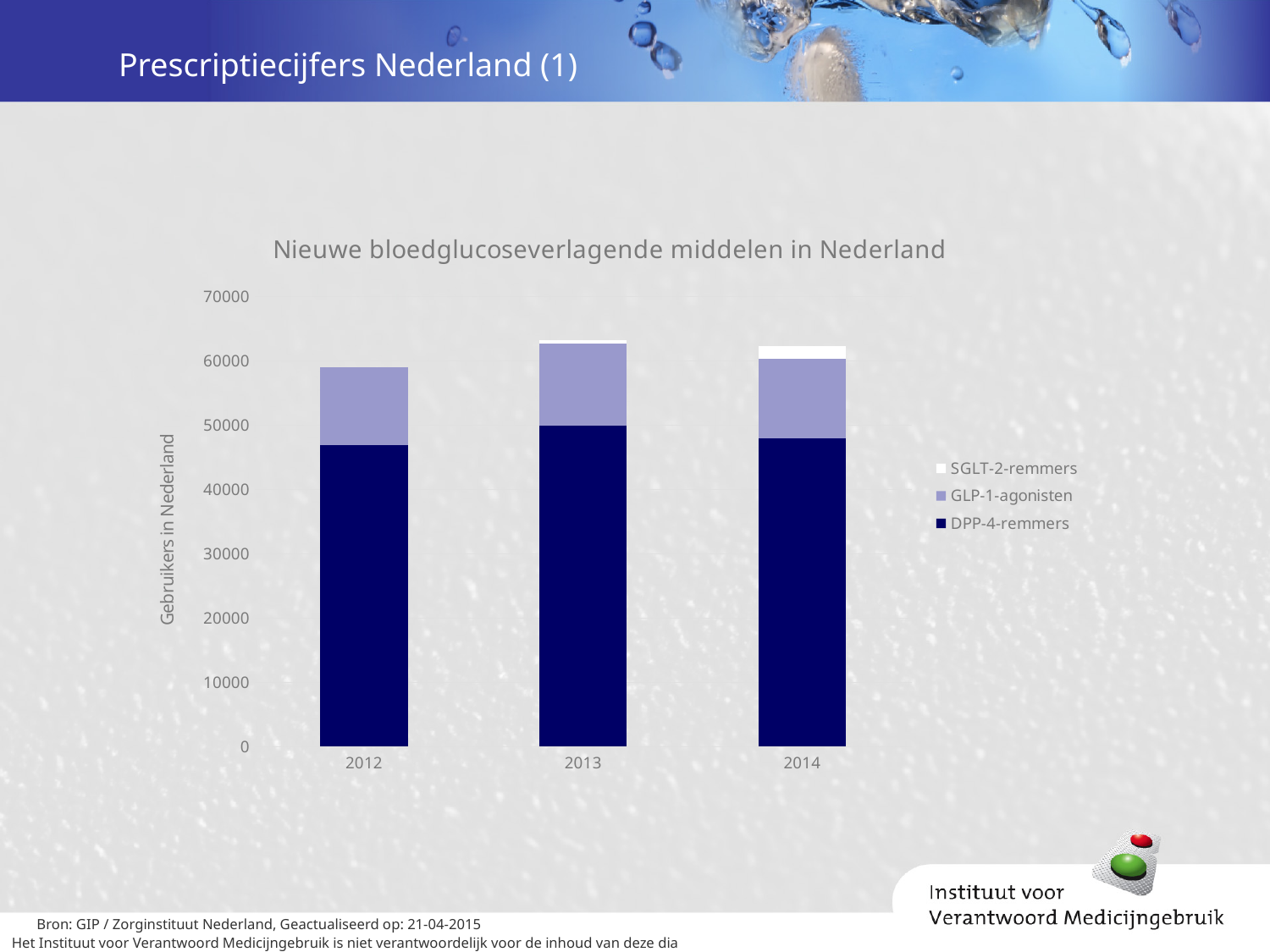
Is the value for DPP-4-remmers in 2012 greater or less than 50000? less What is the title of the chart? Nieuwe bloedglucoseverlagende middelen in Nederland Does the value for DPP-4-remmers rise or fall from 2012 to 2013? rise How many years are shown on the x axis of the chart? 3 Which year has the highest value for DPP-4-remmers? 2013 Is the total stacked bar for 2012 greater or less than 60000? less What kind of chart is shown on the slide? stacked bar chart How many series does the legend list? 3 Is the total stacked bar for 2013 greater or less than 60000? greater What is the label on the vertical axis of the chart? Gebruikers in Nederland Which year has the lowest total stacked bar? 2012